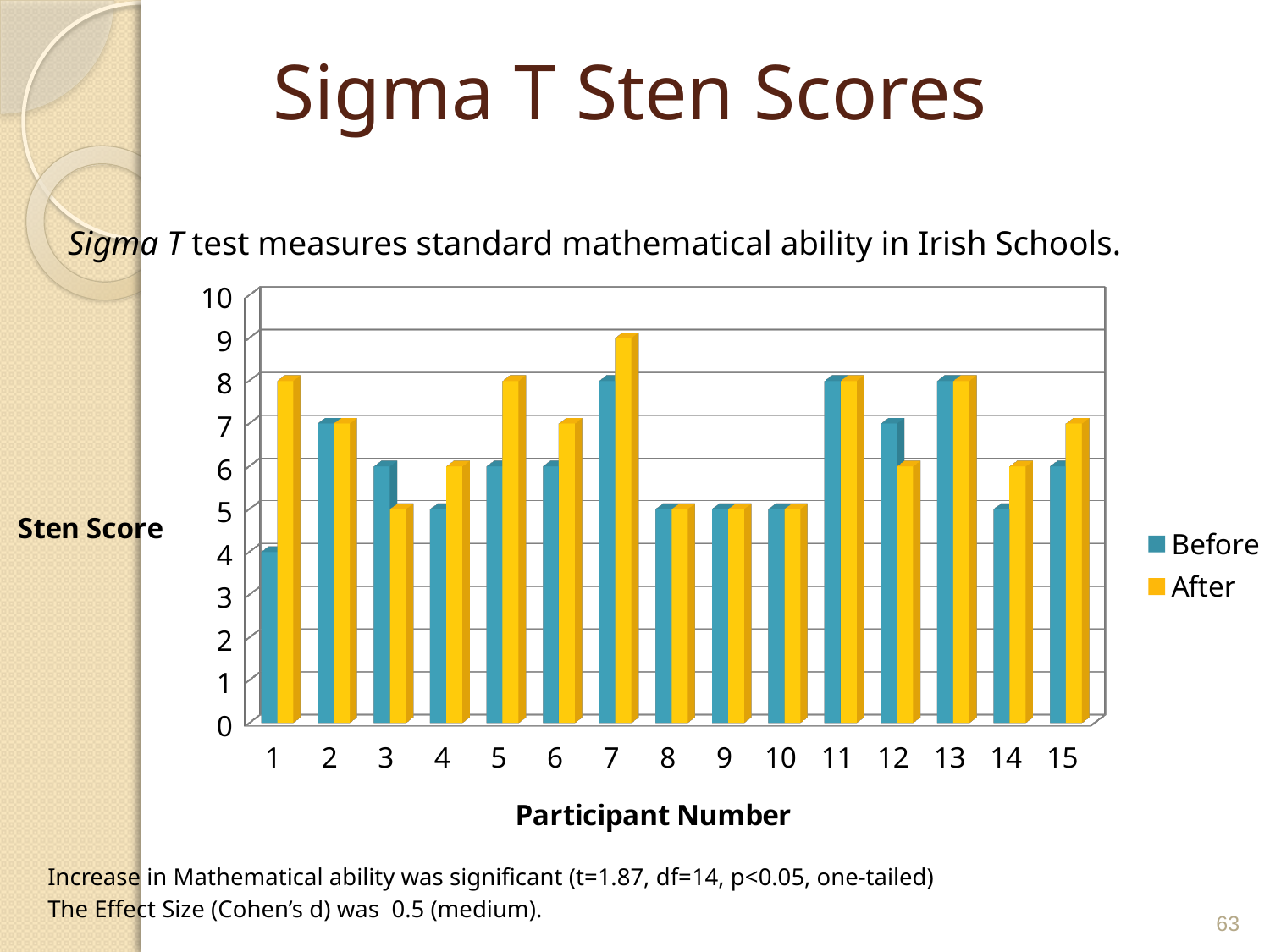
What is the label of the x axis? Participant Number How many participants are shown on the x axis? 15 What kind of chart is shown on the slide? Bar chart Which participant has the highest After sten score? 7 Which participant has the lowest Before sten score? 1 What is the After sten score for participant 7? 9 For participant 12, which is larger, the Before or the After sten score? Before What is the difference between the After and Before sten scores for participant 1? 4 What is the After sten score for participant 3? 5 What is the Before sten score for participant 1? 4 How many series does the legend list? 2 Is the After sten score for participant 5 greater or less than 6? greater